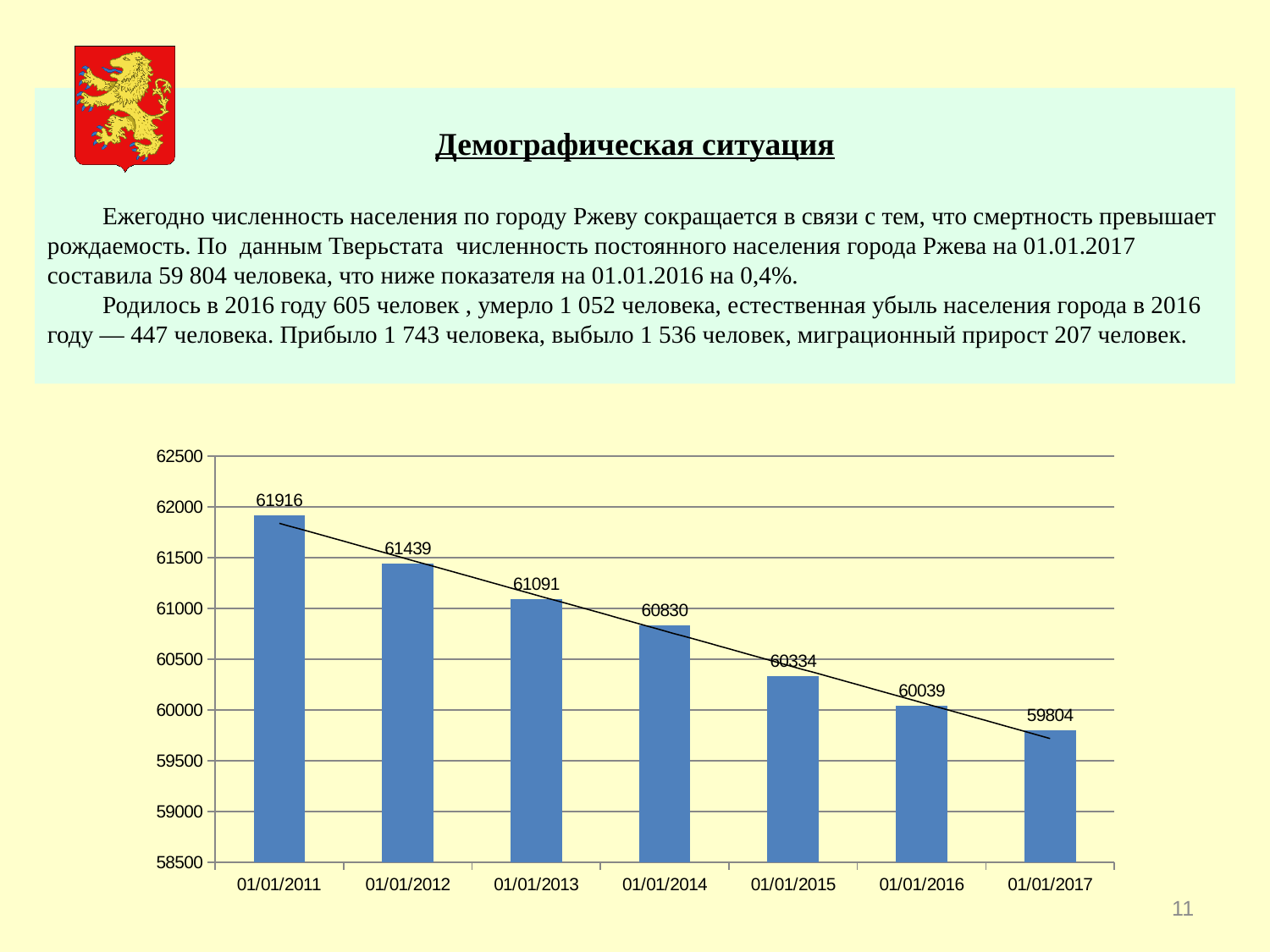
What kind of chart is shown on the slide? bar chart How many dates are shown on the x axis? 7 Is the value for 01/01/2015 greater or less than 60500? less What is the difference between the values for 01/01/2011 and 01/01/2017? 2112 What is the value for 01/01/2017? 59804 Which date has the highest value? 01/01/2011 What is the difference between the values for 01/01/2015 and 01/01/2016? 295 Which date has the lowest value? 01/01/2017 What is the value for 01/01/2011? 61916 What is the value for 01/01/2014? 60830 Do the values rise or fall from 01/01/2011 to 01/01/2017? fall Which is larger, the value for 01/01/2012 or the value for 01/01/2013? 01/01/2012